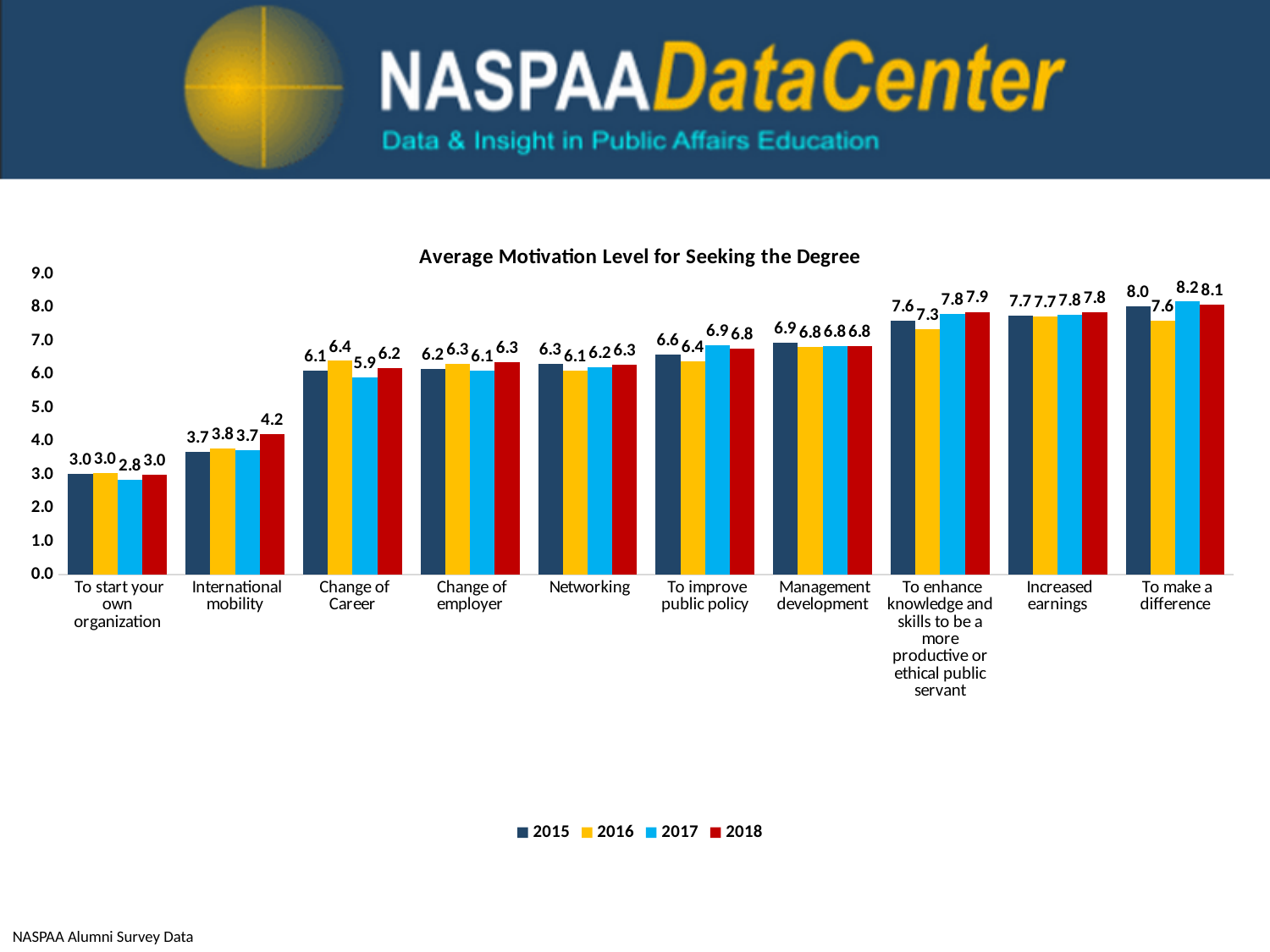
Which is larger for To improve public policy: the 2015 value or the 2017 value? 2017 What is the 2015 value for To enhance knowledge and skills to be a more productive or ethical public servant? 7.6 What is the 2018 value for International mobility? 4.2 What kind of chart is shown? Bar chart How many series does the legend list? 4 Which category has the lowest 2018 value? To start your own organization What is the difference between the 2018 and 2016 values for To make a difference? 0.5 What is the title of the chart? Average Motivation Level for Seeking the Degree How many categories are shown on the x axis? 10 Which category has the highest 2017 value? To make a difference What is the 2017 value for Change of Career? 5.9 What is the 2016 value for To make a difference? 7.6